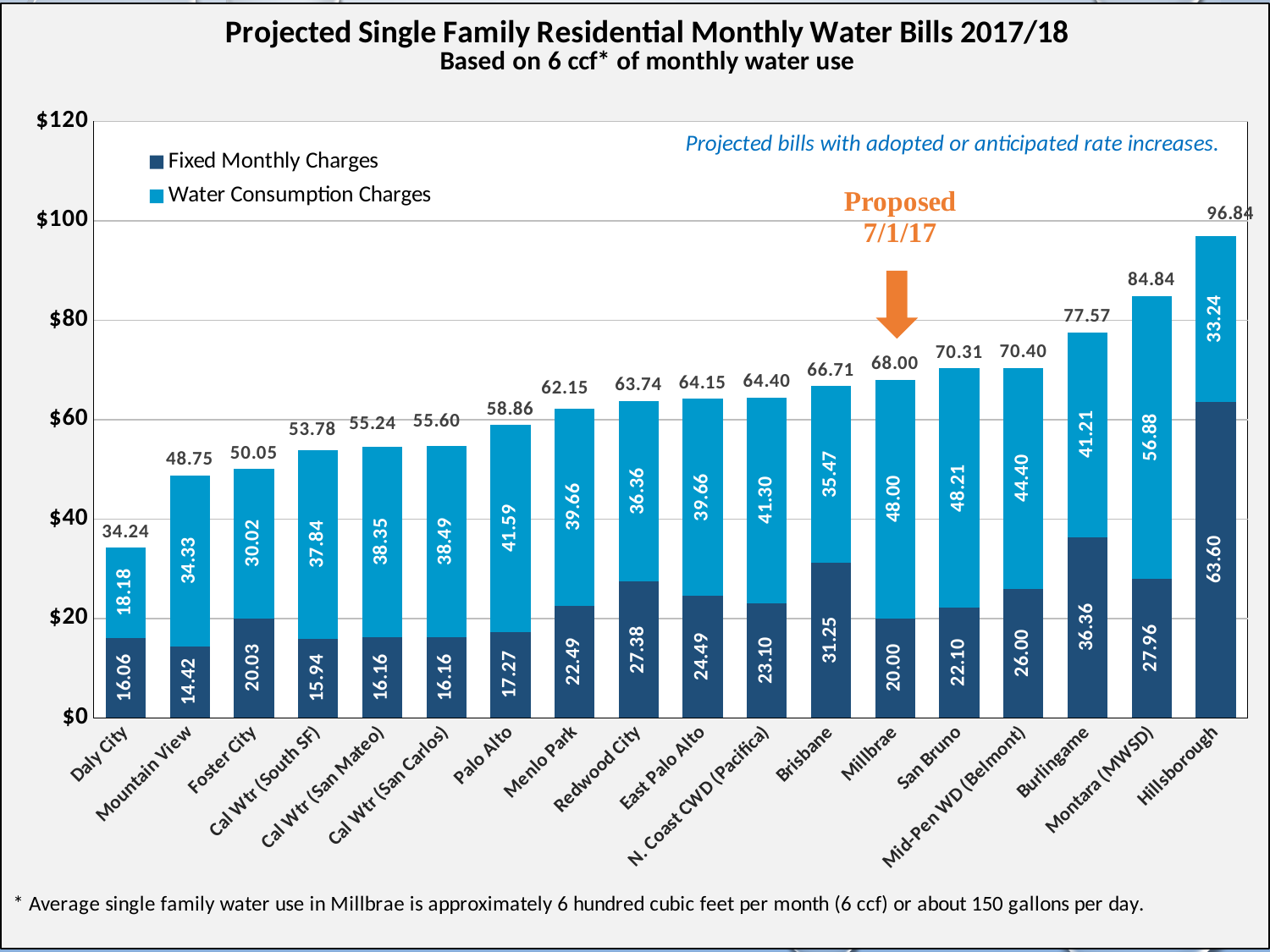
Which agency is marked with the 'Proposed 7/1/17' arrow? Millbrae What is the difference between the total bills for Montara (MWSD) and Millbrae? 16.84 How many series does the legend list? 2 Is the total bill for Palo Alto greater or less than $60? less What is the Water Consumption Charges value for Hillsborough? 33.24 What kind of chart is shown on the slide? Stacked bar chart What is the total projected monthly water bill for Burlingame? 77.57 Which has a larger Fixed Monthly Charges value, Brisbane or San Bruno? Brisbane Which agency has the lowest total projected monthly water bill? Daly City How many agencies are shown on the x axis? 18 Which agency has the highest total projected monthly water bill? Hillsborough What is the Fixed Monthly Charges value for Millbrae? 20.00